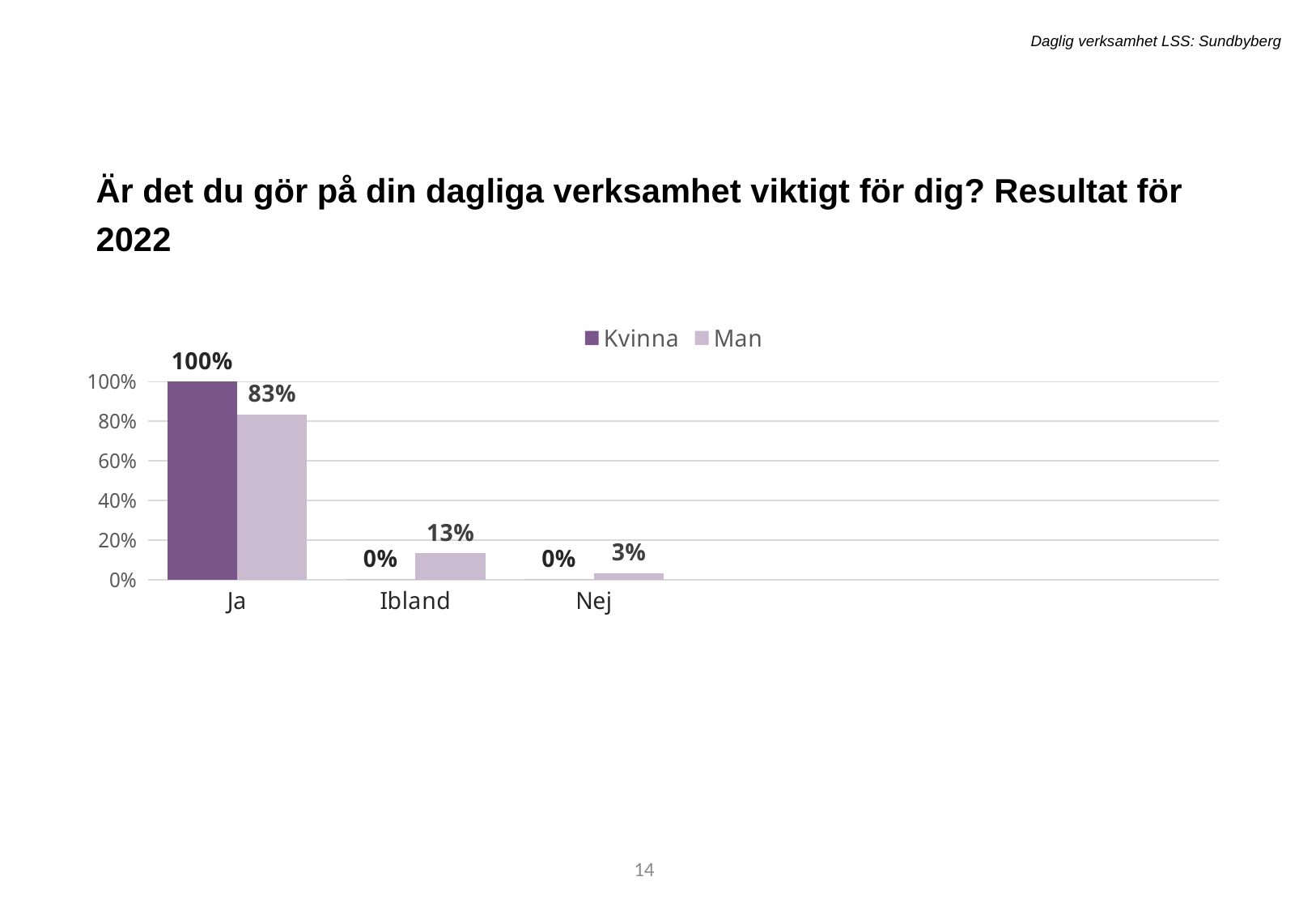
Which category has the lowest value for the Man series? Nej How many series does the legend list? 2 What is the value for Man in the Ibland category? 13% What percentage of Kvinna respondents answered Ja? 100% What percentage of Man respondents answered Ja? 83% What is the difference between the Kvinna and Man values for Ja? 17% For the Ibland category, which series has the larger value, Kvinna or Man? Man What is the value for Man in the Nej category? 3% What type of chart is shown on the slide? Bar chart How many answer categories are shown on the x axis? 3 Which category has the highest value for the Man series? Ja What is the value for Kvinna in the Nej category? 0%